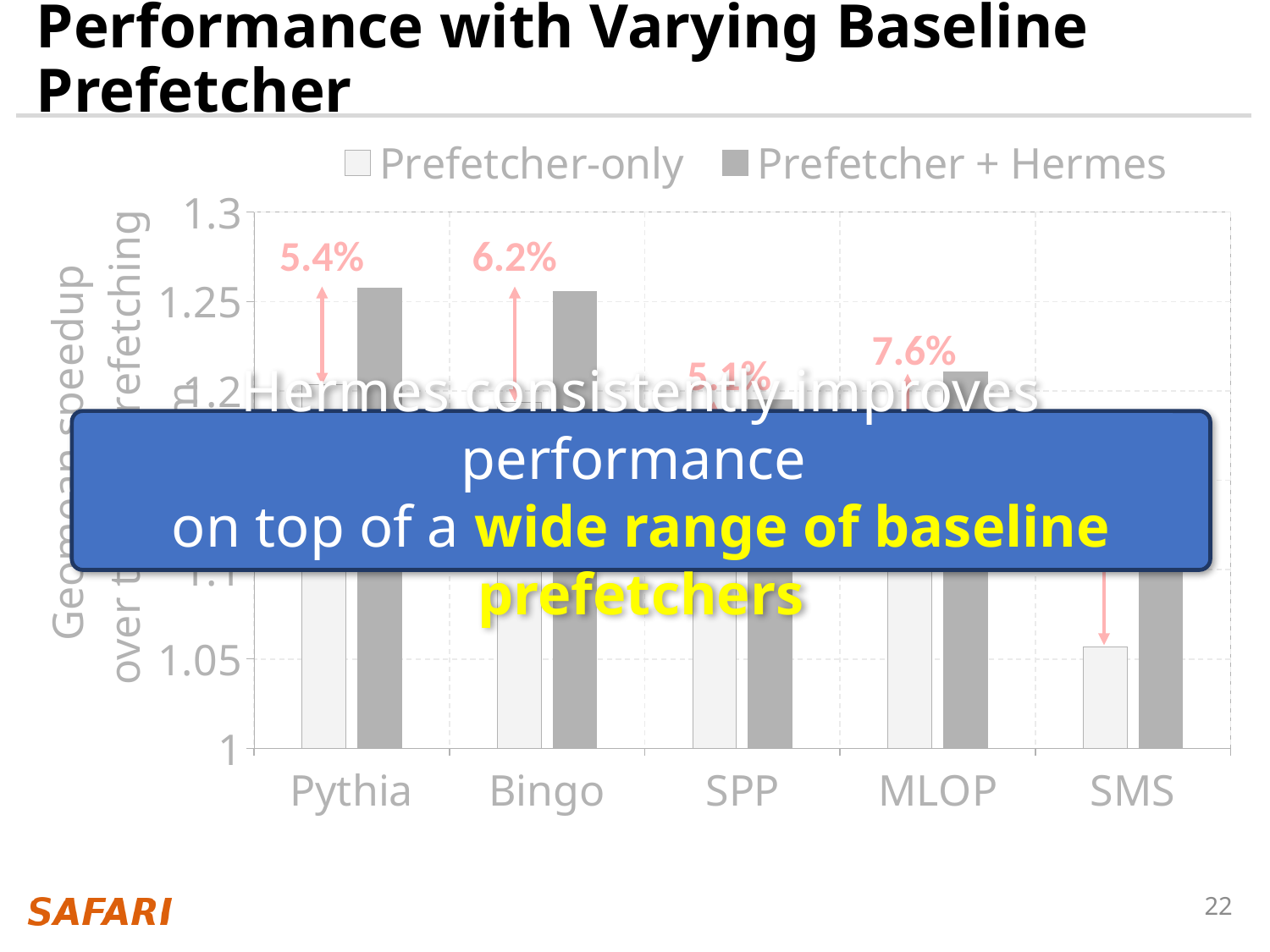
What improvement percentage is annotated above the Pythia bars? 5.4% What improvement percentage is annotated above the SPP bars? 5.1% What improvement percentage is annotated above the Bingo bars? 6.2% What kind of chart is shown on the slide? bar chart How many series does the legend list? 2 For Pythia, which bar is taller: Prefetcher-only or Prefetcher + Hermes? Prefetcher + Hermes Is the Prefetcher-only value for SMS greater or less than 1.1? less How many baseline prefetchers are shown on the x axis? 5 What are the two legend entries of the chart? Prefetcher-only and Prefetcher + Hermes Which prefetcher has the lowest Prefetcher + Hermes bar? SMS What improvement percentage is annotated above the MLOP bars? 7.6% Is the Prefetcher + Hermes value for Pythia greater or less than 1.2? greater